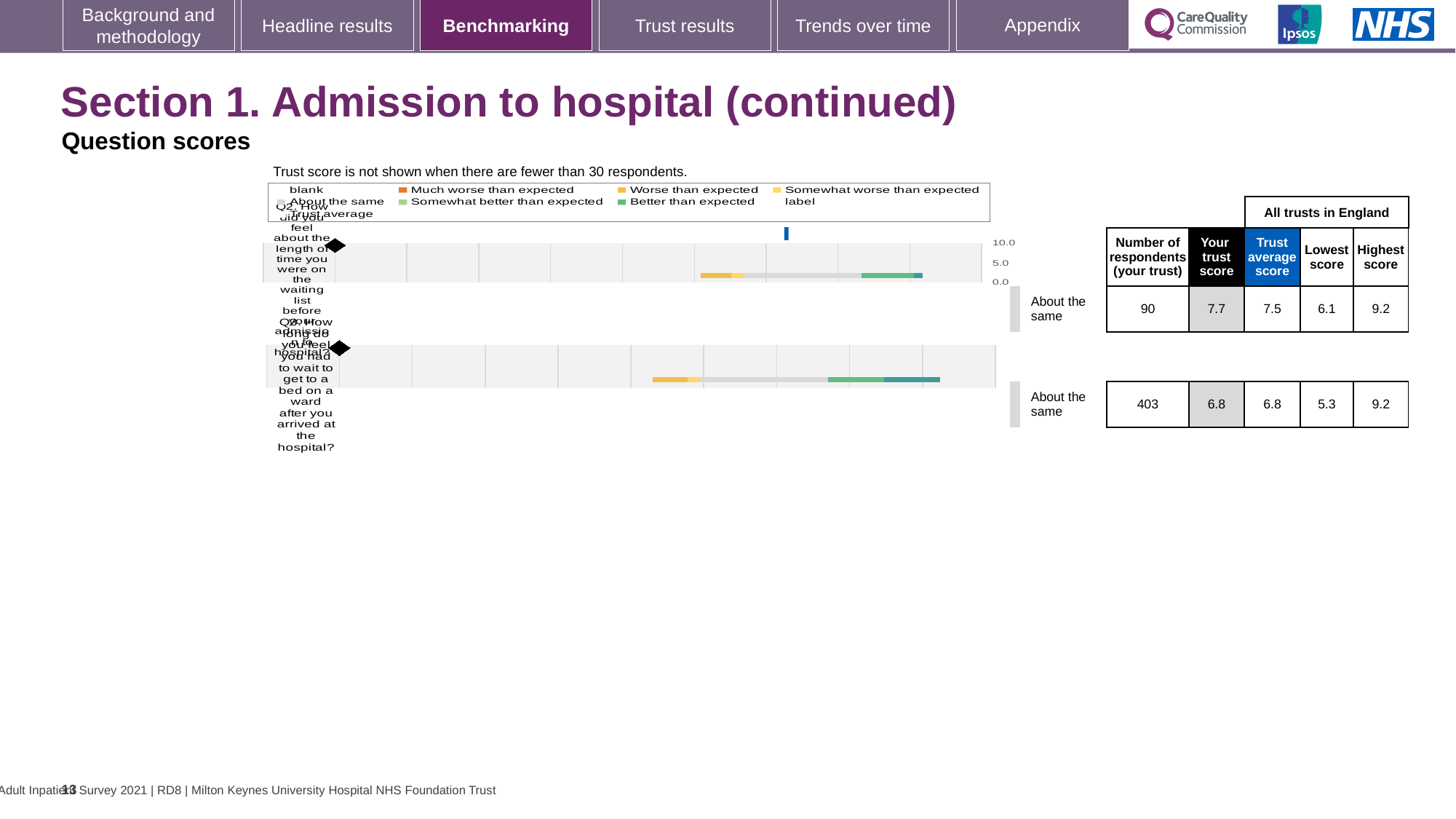
How many questions are plotted on the chart? 2 What benchmark category is shown for Q2 and Q3? About the same Which question has the higher 'Your trust score', Q2 or Q3? Q2 What is the highest score across all trusts in England for Q2? 9.2 What is the difference between the trust score and the trust average score for Q2? 0.2 What is the maximum value shown on the chart's score axis? 10.0 What is the difference between the highest and lowest scores across all trusts in England for Q3? 3.9 What is the 'Your trust score' for Q2 (how did you feel about the length of time you were on the waiting list before admission)? 7.7 What is the trust average score for Q2? 7.5 How many respondents answered Q3 for this trust? 403 What is the lowest score across all trusts in England for Q3? 5.3 What is the 'Your trust score' for Q3 (how long did you feel you had to wait to get to a bed on a ward after you arrived at the hospital)? 6.8